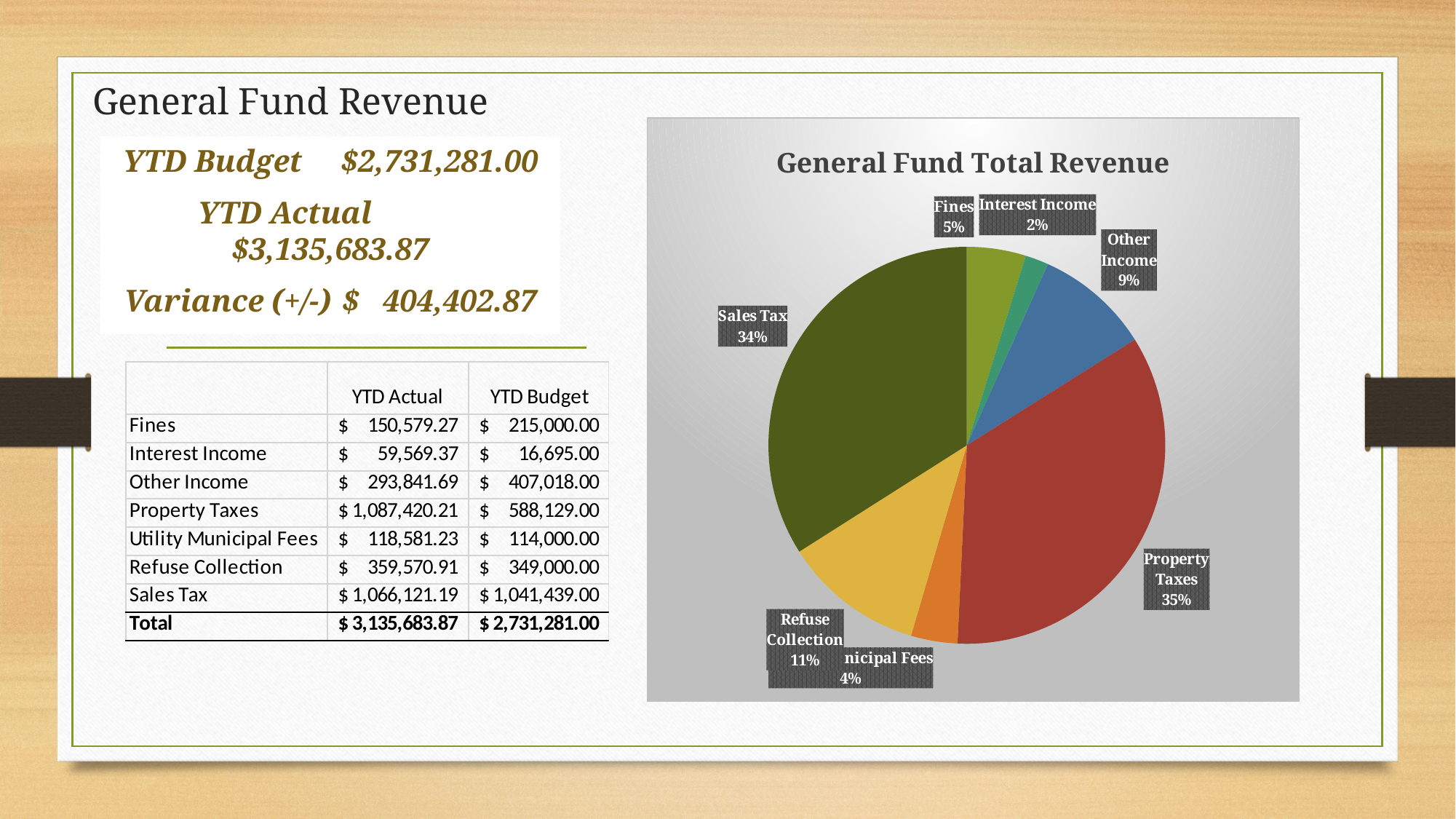
What is the title of the chart? General Fund Total Revenue Which has a larger share of the pie, Other Income or Fines? Other Income How many percentage points larger is the Sales Tax share than the Refuse Collection share? 23 percentage points What percentage is shown for Other Income in the pie chart? 9% What kind of chart is shown on the slide? Pie chart Which category has the largest share of the pie? Property Taxes What percentage is shown for Fines in the pie chart? 5% Which category has the smallest share of the pie? Interest Income What share of the pie does Sales Tax represent? 34% How many slices does the pie chart have? 7 What percentage is shown for Property Taxes in the pie chart? 35% What percentage is shown for Refuse Collection in the pie chart? 11%